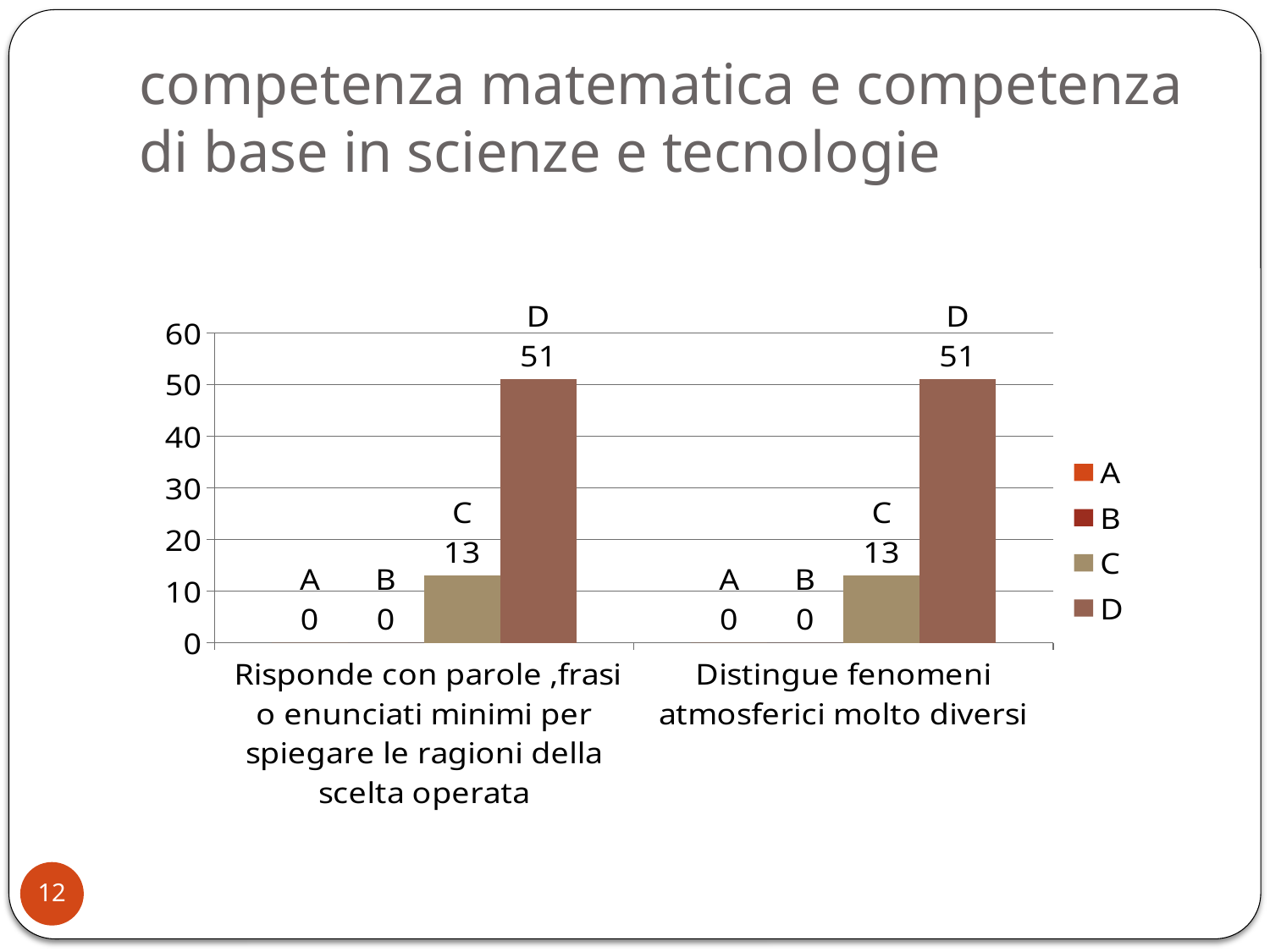
What is the value for series A in the category "Distingue fenomeni atmosferici molto diversi"? 0 What is the value for series C in the category "Risponde con parole, frasi o enunciati minimi per spiegare le ragioni della scelta operata"? 13 In the category "Distingue fenomeni atmosferici molto diversi", which is larger: the value for series C or the value for series D? D What is the value for series D in the category "Distingue fenomeni atmosferici molto diversi"? 51 Which series has the highest value in the category "Risponde con parole, frasi o enunciati minimi per spiegare le ragioni della scelta operata"? D Is the value for series D in the category "Distingue fenomeni atmosferici molto diversi" greater or less than 40? greater How many series does the legend list? 4 What is the total of the values for series A, B, C and D in the category "Risponde con parole, frasi o enunciati minimi per spiegare le ragioni della scelta operata"? 64 What kind of chart is shown on the slide? bar chart What is the highest value shown on the vertical axis of the chart? 60 What is the difference between the values for series D and series C in the category "Distingue fenomeni atmosferici molto diversi"? 38 How many categories are shown on the x axis of the chart? 2